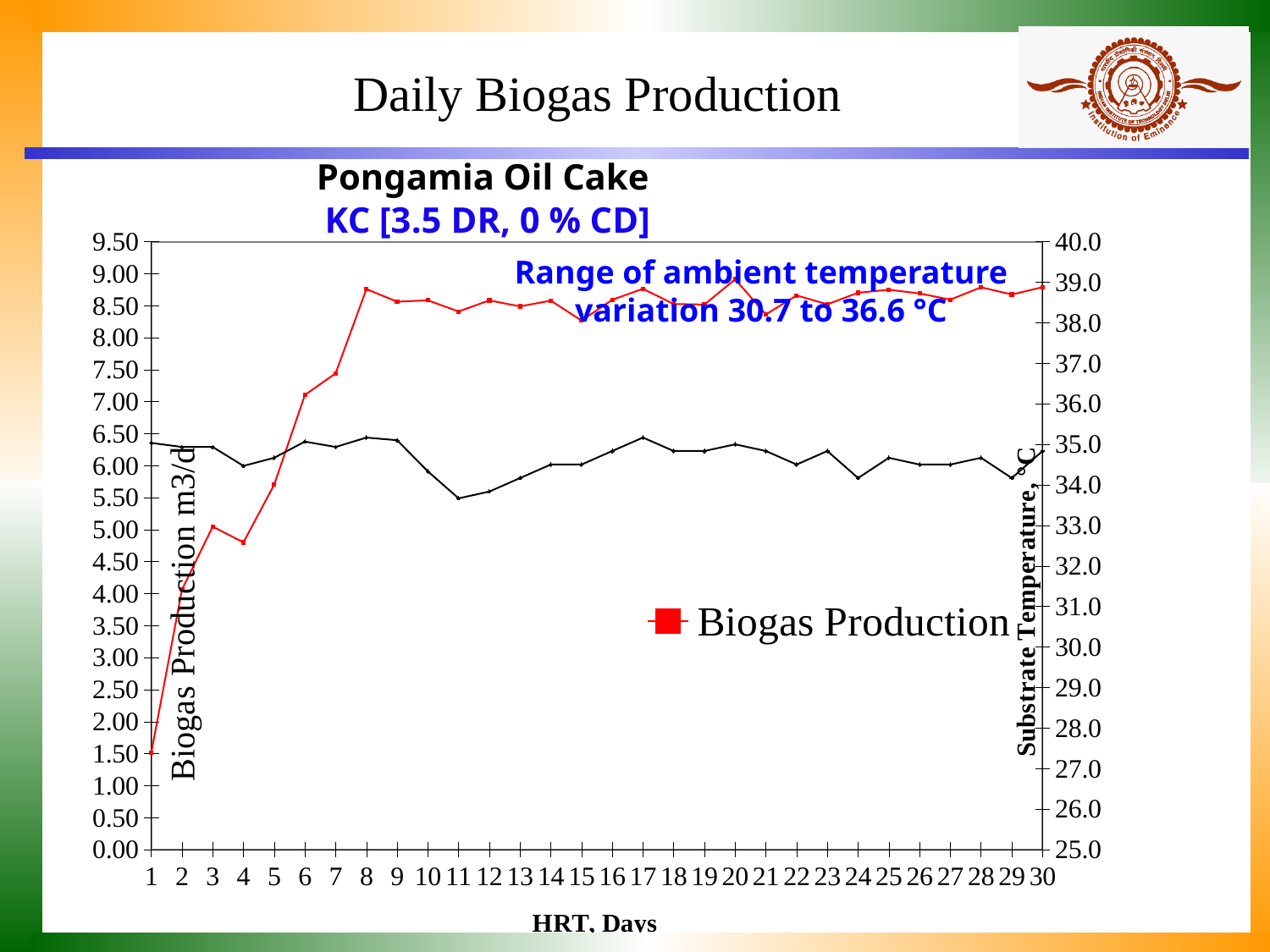
Is the Biogas Production value on day 8 greater or less than 8.00? greater What range of ambient temperature variation is stated on the chart? 30.7 to 36.6 °C What is the label of the x axis? HRT, Days On which day is Biogas Production lowest? 1 Is the Biogas Production value on day 1 greater or less than 2.00? less What kind of chart is shown on the slide? line chart Is the Biogas Production value on day 5 greater or less than 5.00? greater Does Biogas Production generally rise or fall from day 1 to day 8? rise How many series does the chart legend list? 1 Which day has the larger Biogas Production value, day 4 or day 8? day 8 How many days (x-axis points) are plotted on the chart? 30